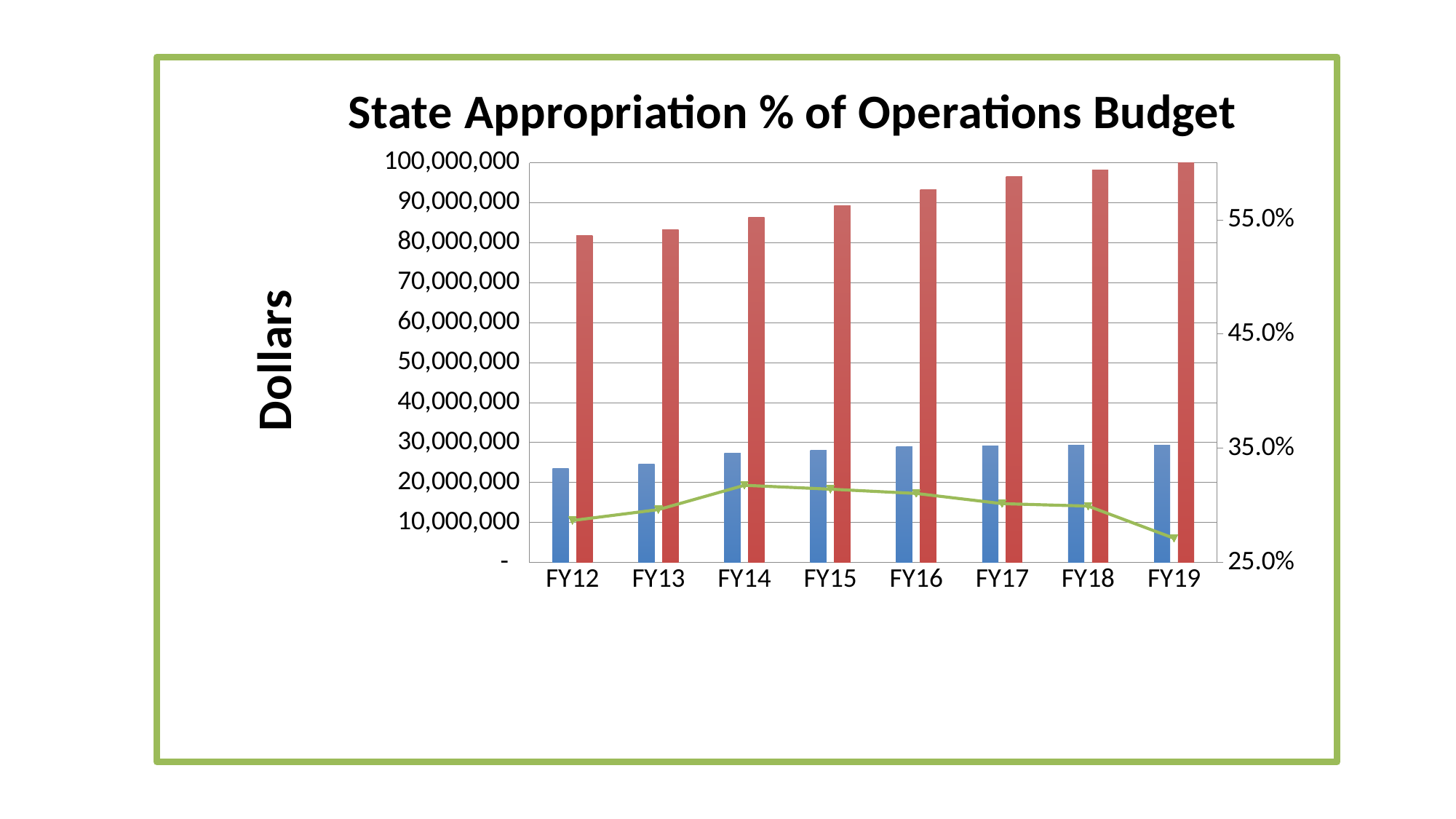
Which fiscal year has the shortest red bar? FY12 Which fiscal year has the shortest blue bar? FY12 At which fiscal year does the green line reach its highest point? FY14 What kind of chart is this? Combination bar and line chart What is the title of the chart? State Appropriation % of Operations Budget What is the label on the left vertical axis of the chart? Dollars Do the red bars rise or fall from FY12 to FY19? Rise How many fiscal years are shown on the x axis of the chart? 8 Is the red bar for FY16 greater or less than 90,000,000? greater In FY12, which is larger, the red bar or the blue bar? The red bar Is the blue bar for FY12 greater or less than 20,000,000? greater Which fiscal year has the tallest red bar? FY19